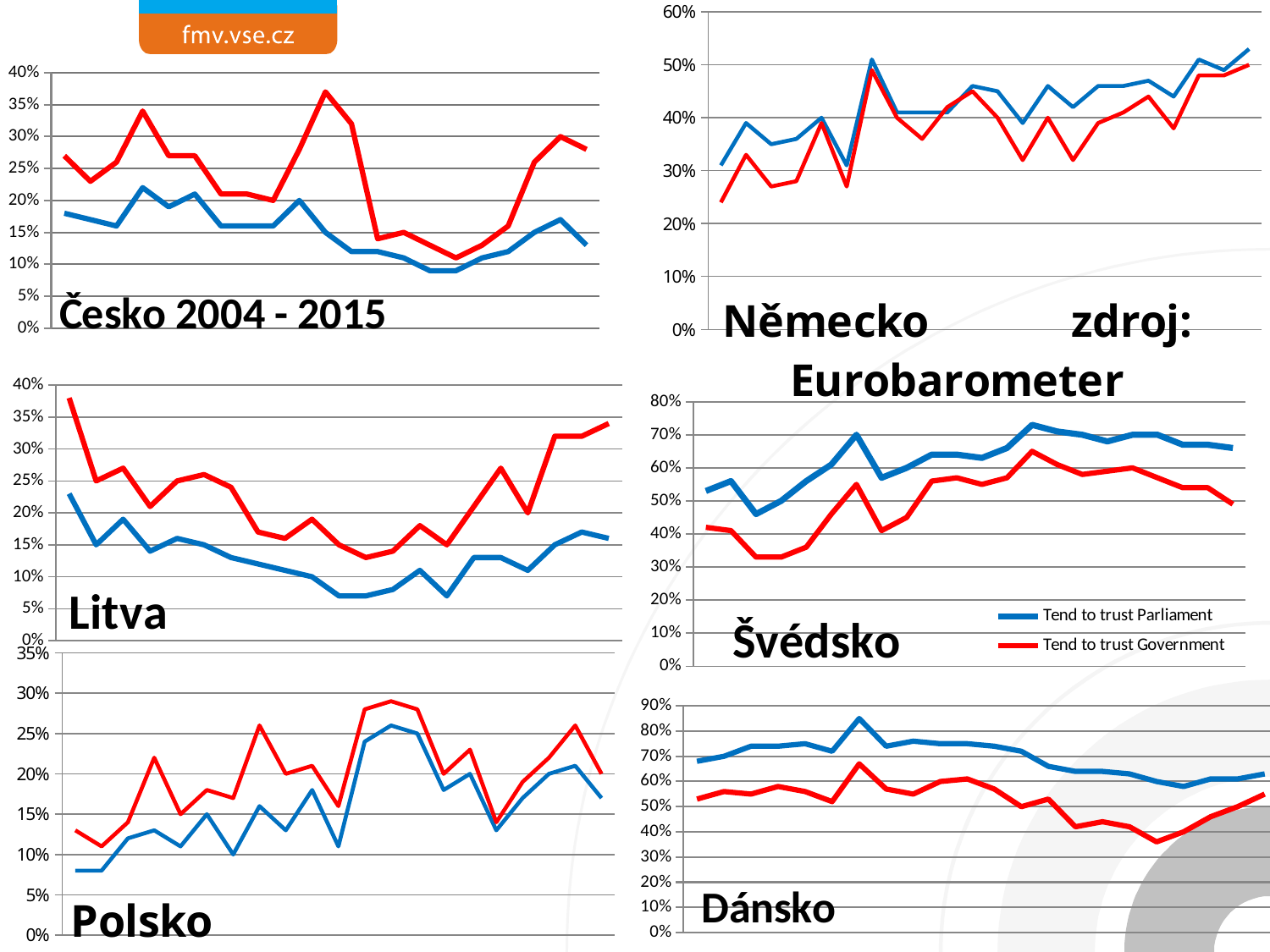
How many series does the legend in the Švédsko chart list? 2 In the Litva chart, which series has the higher value at the first point? Tend to trust Government In the Německo chart, does the blue line overall rise or fall from the first point to the last point? rise In the Dánsko chart, is the highest value of the blue line greater or less than 80%? greater How many charts are shown on the slide? 6 What type of chart is the Česko 2004 - 2015 chart? line chart What is the highest value shown on the y axis of the Dánsko chart? 90% In the Polsko chart, is the highest value of the red line greater or less than 25%? greater In the Švédsko chart legend, which colour represents 'Tend to trust Government'? red In the Litva chart, is the lowest value of the blue line greater or less than 10%? less In the Švédsko chart, which series has the higher value at the last point? Tend to trust Parliament